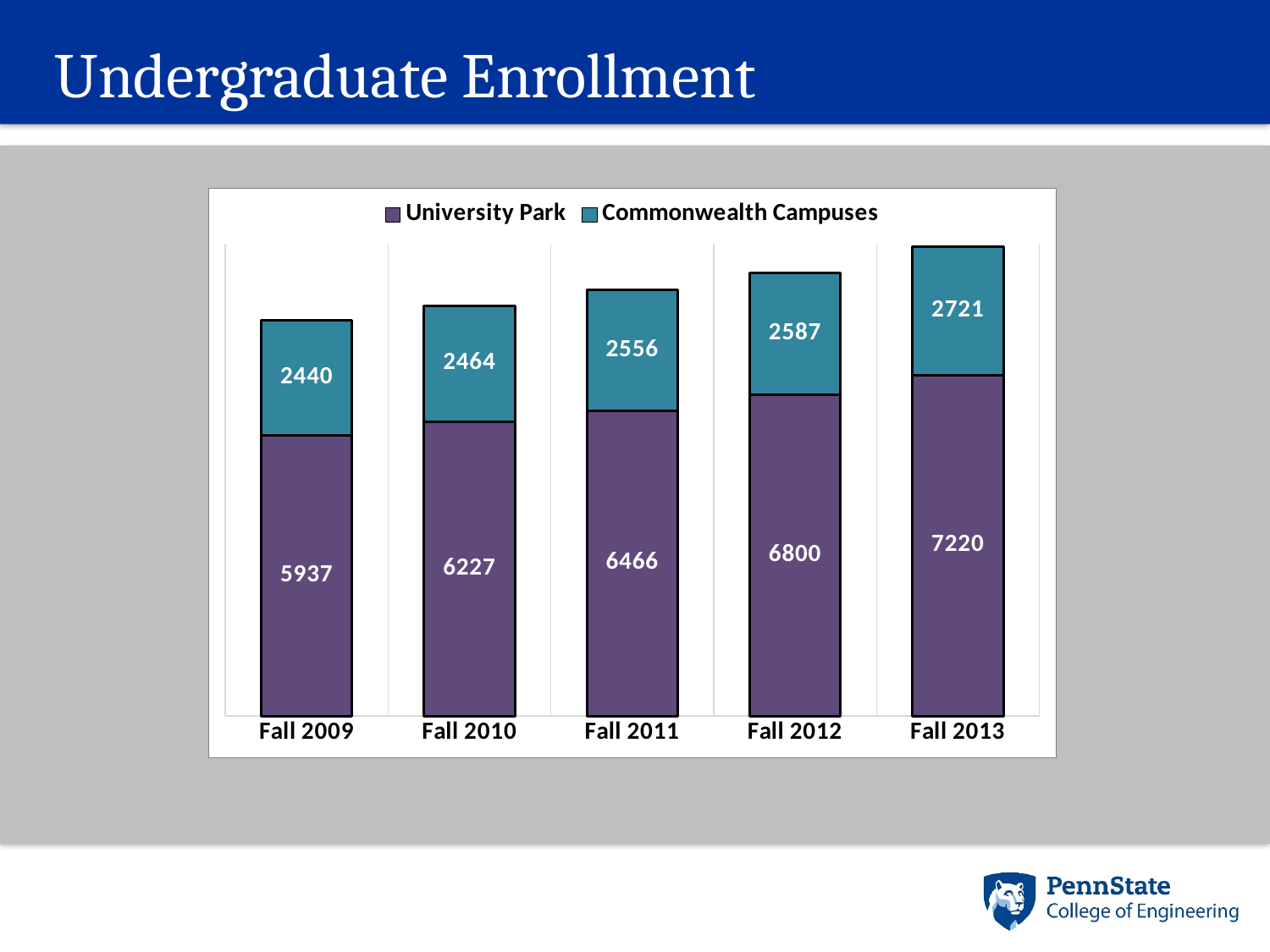
What is the University Park enrollment for Fall 2011? 6466 What is the total undergraduate enrollment for Fall 2013? 9941 Which year has the lowest Commonwealth Campuses enrollment? Fall 2009 How many series does the legend list? 2 Which year has the highest University Park enrollment? Fall 2013 Which is larger: Commonwealth Campuses enrollment in Fall 2010 or in Fall 2012? Fall 2012 How many years are shown on the x axis? 5 What is the difference between University Park enrollment in Fall 2013 and Fall 2012? 420 What is the total undergraduate enrollment for Fall 2009 (University Park plus Commonwealth Campuses)? 8377 What is the Commonwealth Campuses enrollment for Fall 2009? 2440 Does University Park enrollment rise or fall from Fall 2009 to Fall 2013? rise What is the Commonwealth Campuses enrollment for Fall 2013? 2721